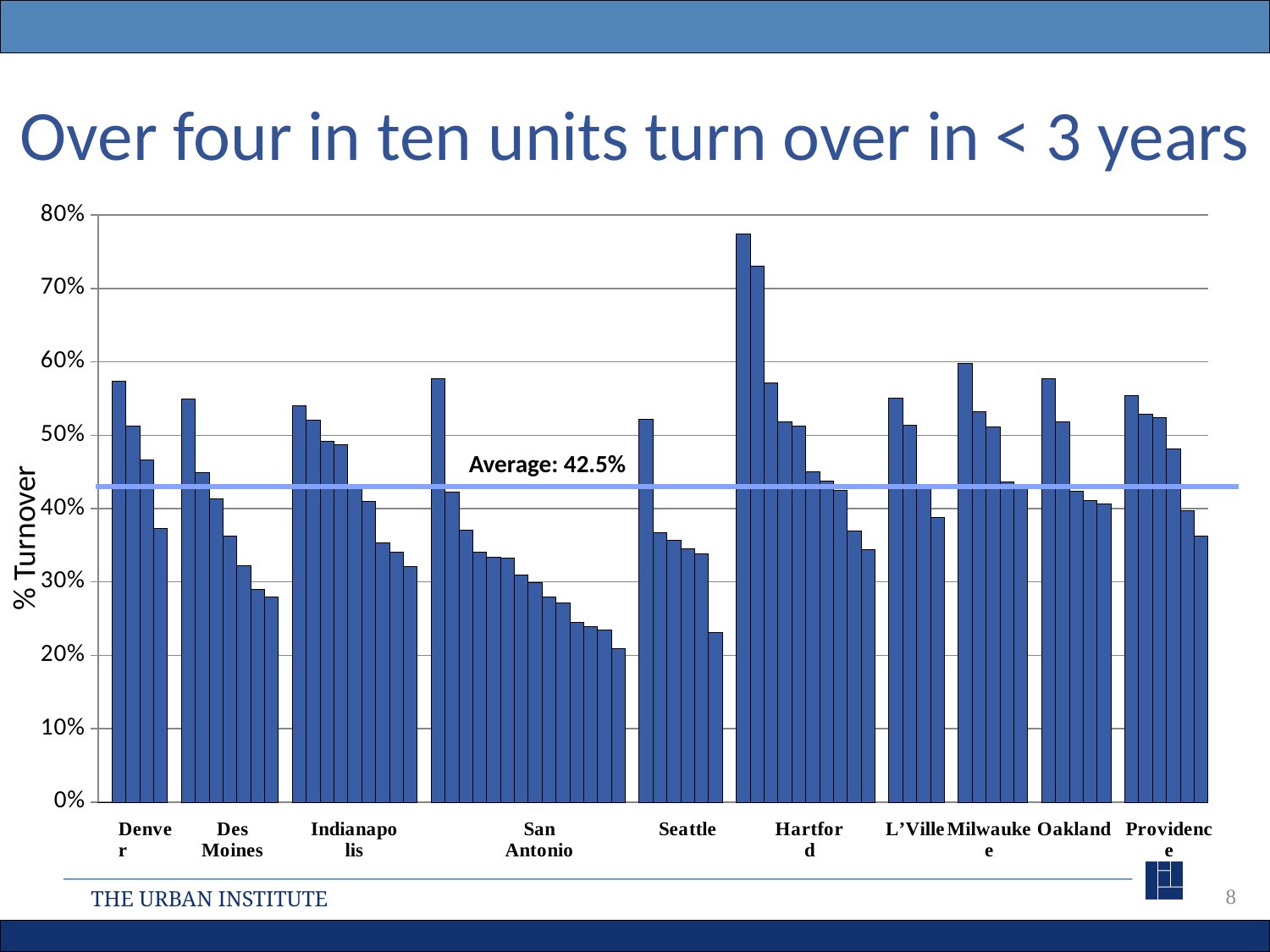
Which city group has the most bars on the chart? San Antonio Which is larger, the tallest bar in the Hartford group or the tallest bar in the Oakland group? Hartford Is the shortest bar in the Seattle group greater or less than 30%? less Is the shortest bar in the San Antonio group greater or less than 30%? less Within each city group, do the bars rise or fall from left to right? fall Is the tallest bar in the Hartford group greater or less than 70%? greater What is the label on the y axis of the chart? % Turnover What kind of chart is shown on the slide? bar chart What is the average turnover value marked by the horizontal line on the chart? 42.5% Which city group contains the tallest bar on the chart? Hartford How many city groups are shown along the x axis of the chart? 10